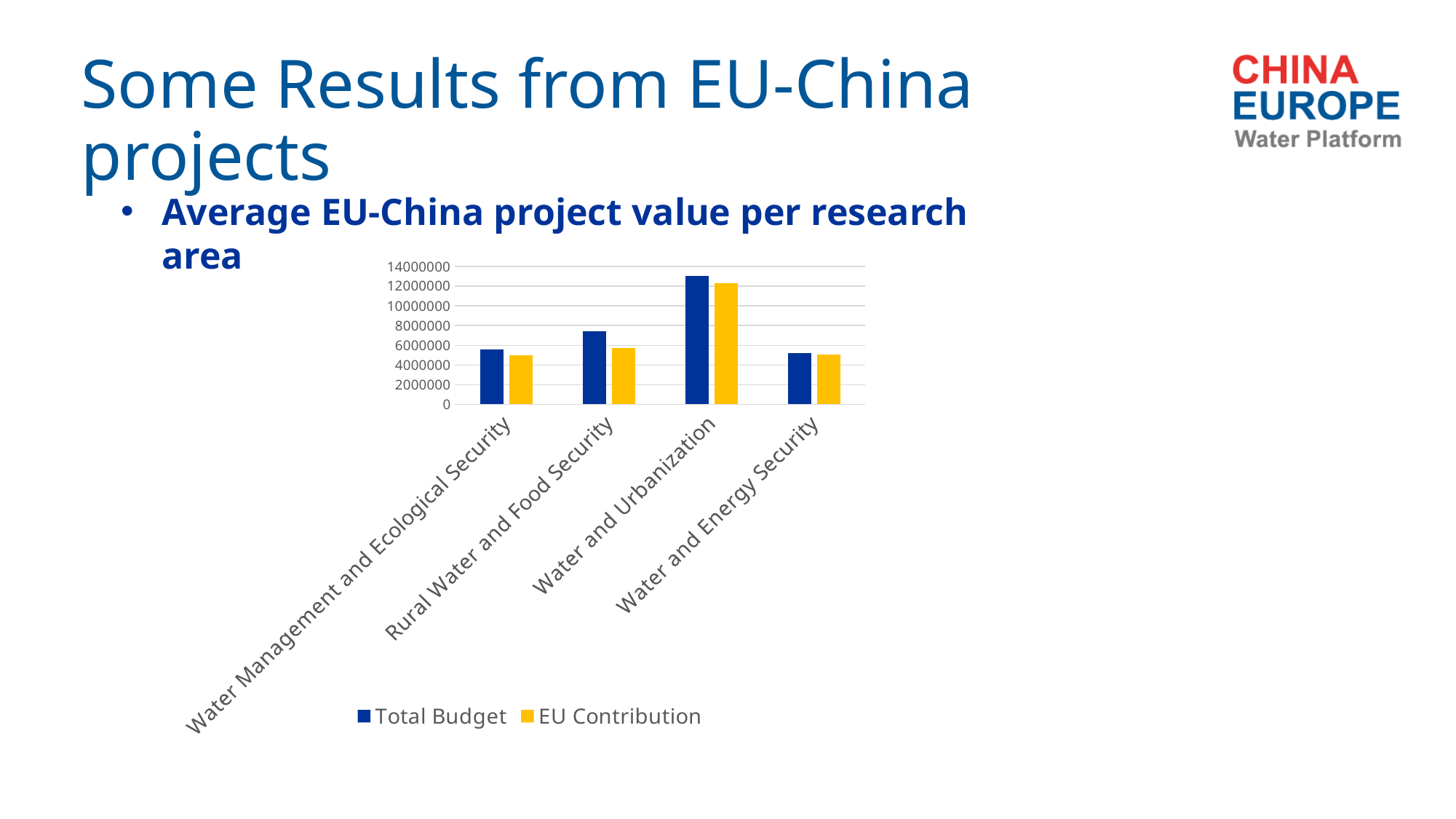
Is the Total Budget for Water and Urbanization greater or less than 12000000? greater Which research area has the highest EU Contribution? Water and Urbanization Which colour represents EU Contribution in the chart's legend? yellow How many research areas are shown on the x axis of the chart? 4 How many series does the chart's legend list? 2 Is the EU Contribution for Water and Energy Security greater or less than 4000000? greater Which is larger: the Total Budget for Water and Urbanization or the Total Budget for Water Management and Ecological Security? Water and Urbanization Is the Total Budget for Rural Water and Food Security greater or less than 8000000? less Which research area has the highest Total Budget? Water and Urbanization For Rural Water and Food Security, which is larger: Total Budget or EU Contribution? Total Budget What kind of chart is shown on the slide? bar chart